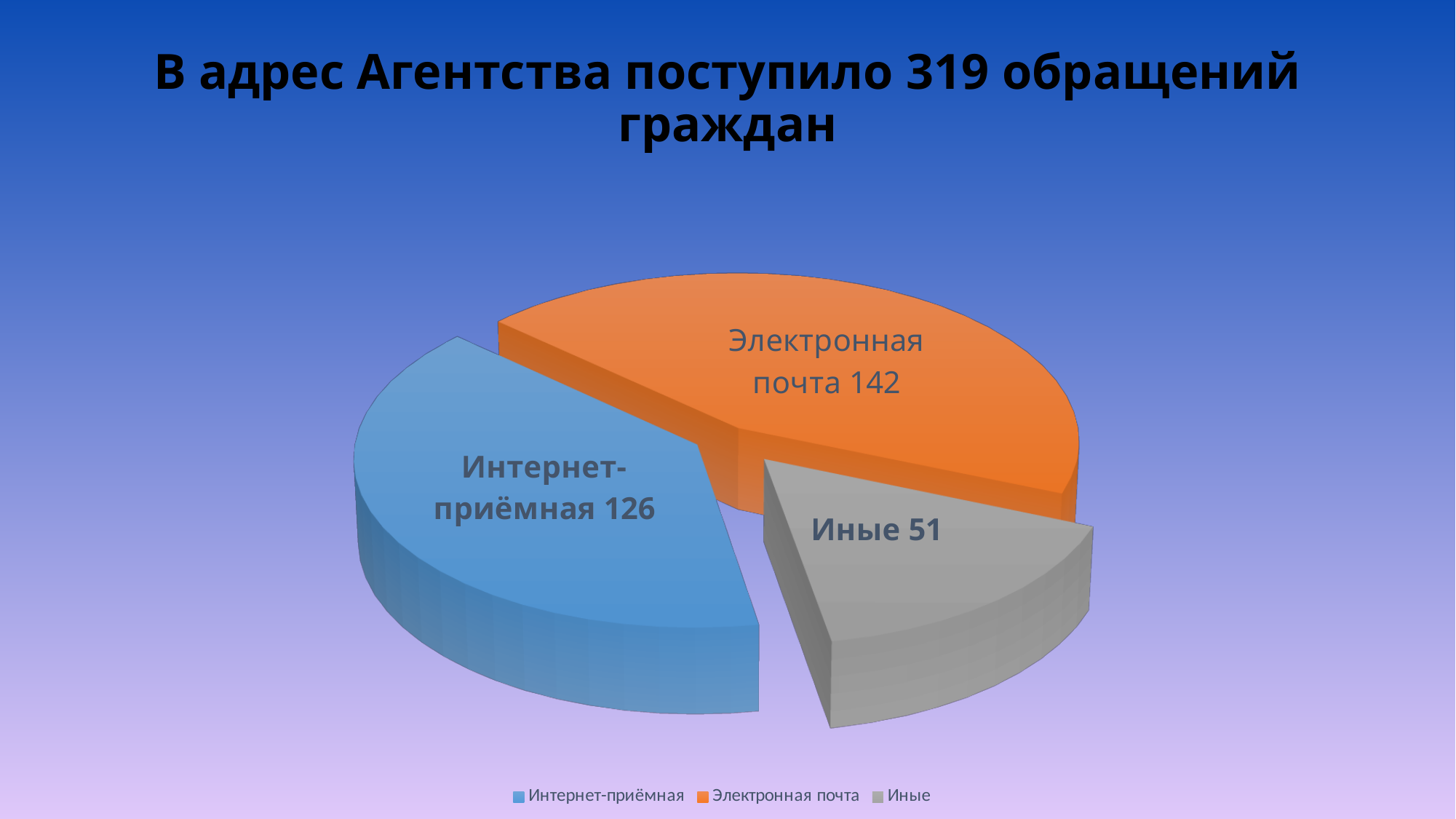
What is the difference between the values for Электронная почта and Интернет-приёмная? 16 Which category has the largest slice? Электронная почта What is the total of all three slices? 319 What is the value for Интернет-приёмная? 126 What is the difference between the values for Интернет-приёмная and Иные? 75 What is the value for Электронная почта? 142 What colour is the slice for Электронная почта? Orange Which category has the smallest slice? Иные Which is larger, the value for Интернет-приёмная or the value for Иные? Интернет-приёмная What type of chart is shown on the slide? Pie chart How many slices does the pie chart have? 3 What is the value for Иные? 51